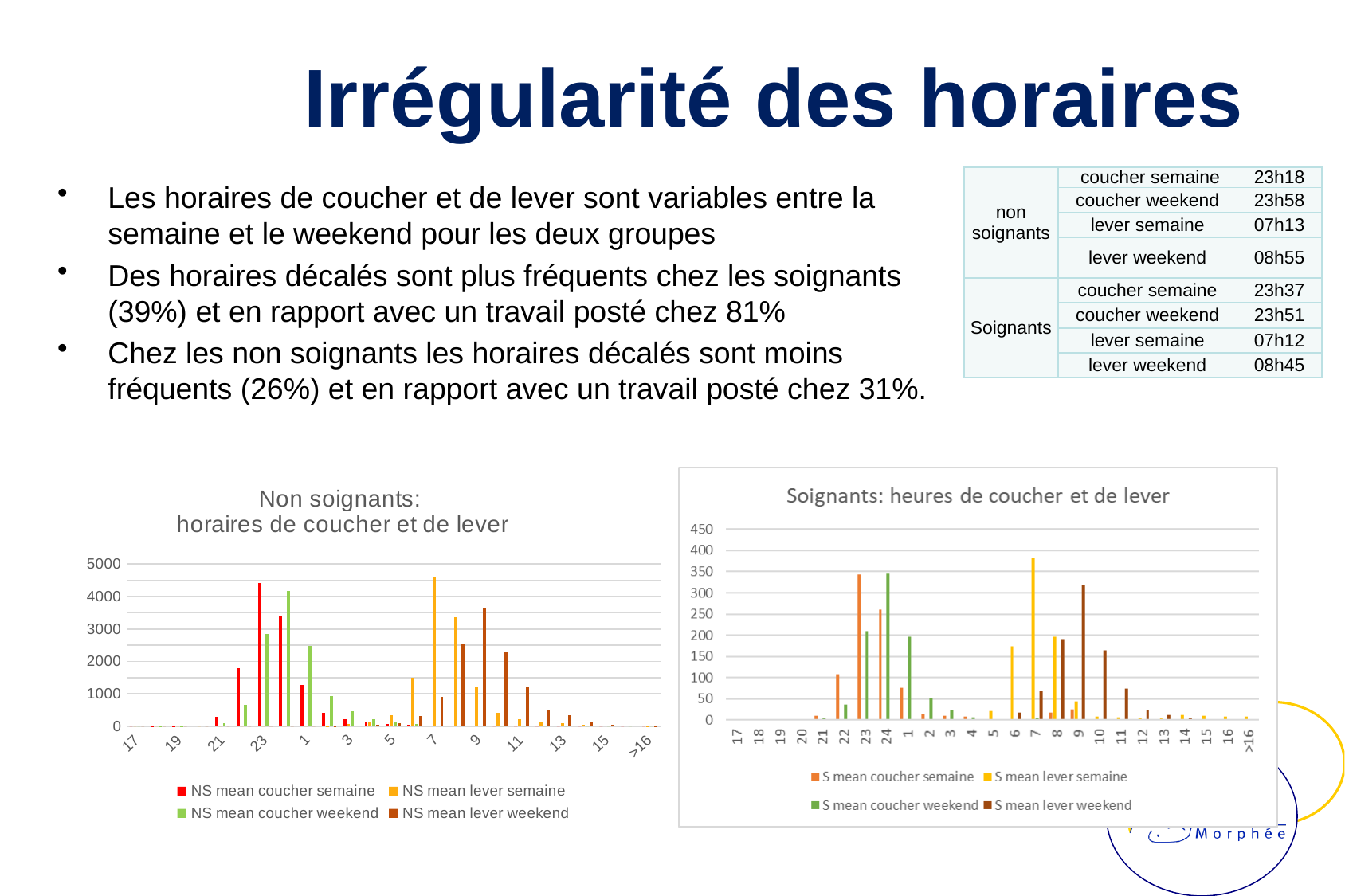
In the 'Non soignants: horaires de coucher et de lever' chart, is the value of 'NS mean lever weekend' at 9 greater or less than 3000? greater In the 'Non soignants: horaires de coucher et de lever' chart, which is larger: 'NS mean coucher semaine' at 23 or 'NS mean lever weekend' at 9? NS mean coucher semaine at 23 What kind of chart is the 'Non soignants: horaires de coucher et de lever' chart? bar chart In the 'Non soignants: horaires de coucher et de lever' chart, at which hour is the 'NS mean lever semaine' series highest? 7 How many series does the legend of the 'Soignants: heures de coucher et de lever' chart list? 4 In the 'Non soignants: horaires de coucher et de lever' chart, at which hour is the 'NS mean coucher semaine' series highest? 23 How many hour categories are shown on the x axis of the 'Soignants: heures de coucher et de lever' chart? 25 In the 'Soignants: heures de coucher et de lever' chart, is the value of 'S mean lever semaine' at 7 greater or less than 350? greater In the 'Soignants: heures de coucher et de lever' chart, at which hour is the 'S mean lever weekend' series highest? 9 In the 'Soignants: heures de coucher et de lever' chart, which is larger: 'S mean lever semaine' at 7 or 'S mean lever weekend' at 9? S mean lever semaine at 7 In the 'Non soignants: horaires de coucher et de lever' chart, is the value of 'NS mean coucher semaine' at 23 greater or less than 4000? greater